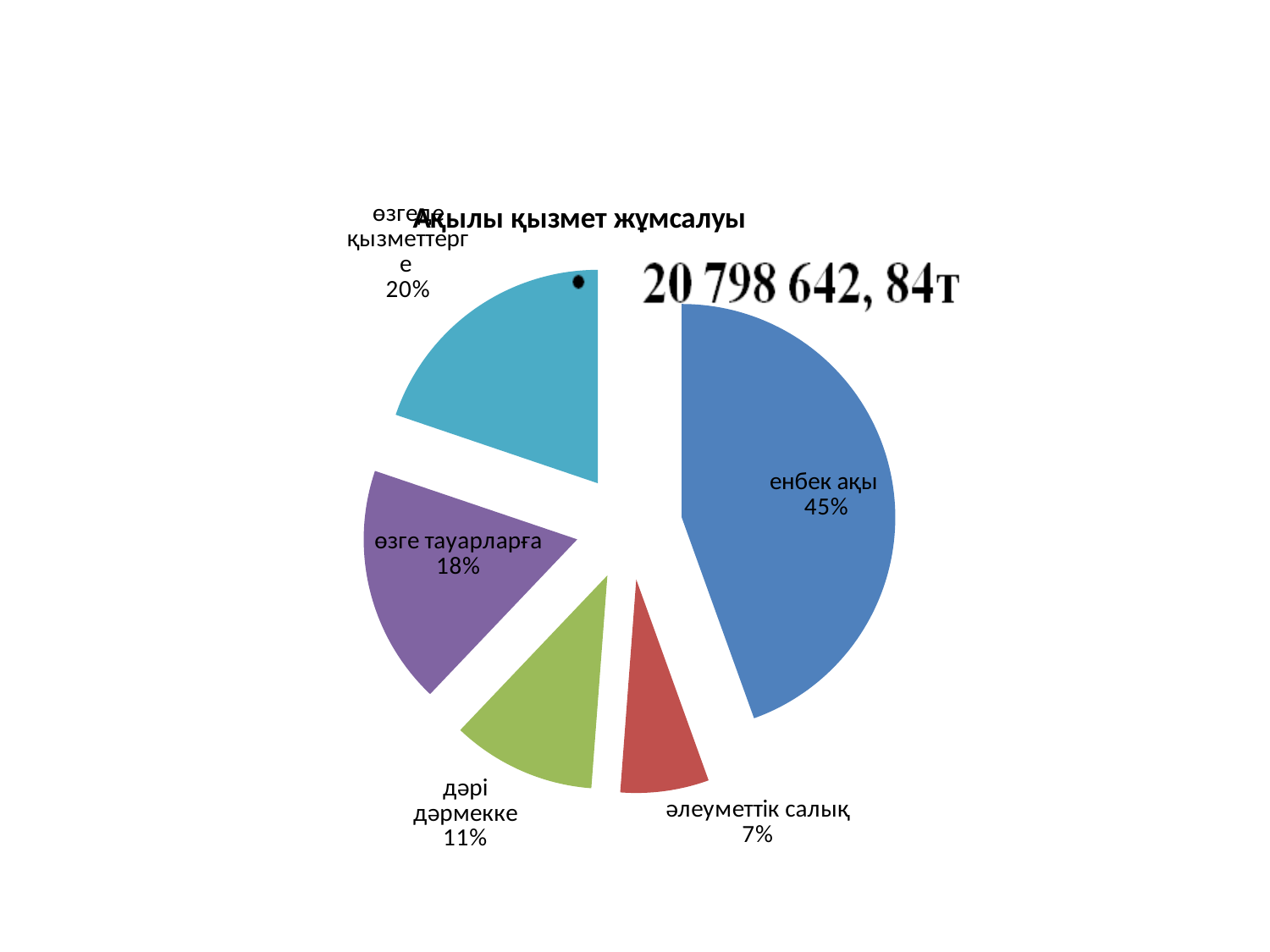
Which category has the smallest slice of the pie? әлеуметтік салық What is the difference in percentage points between енбек ақы and өзге тауарларға? 27 What share of the pie does енбек ақы take? 45% Which category has the largest slice of the pie? енбек ақы What kind of chart is shown on the slide? pie chart What share of the pie does өзге тауарларға take? 18% What is the title of the chart? Ақылы қызмет жұмсалуы How many slices does the pie chart have? 5 What share of the pie does дәрі дәрмекке take? 11% What colour is the енбек ақы slice? blue Which is larger, the share for дәрі дәрмекке or the share for өзге тауарларға? өзге тауарларға